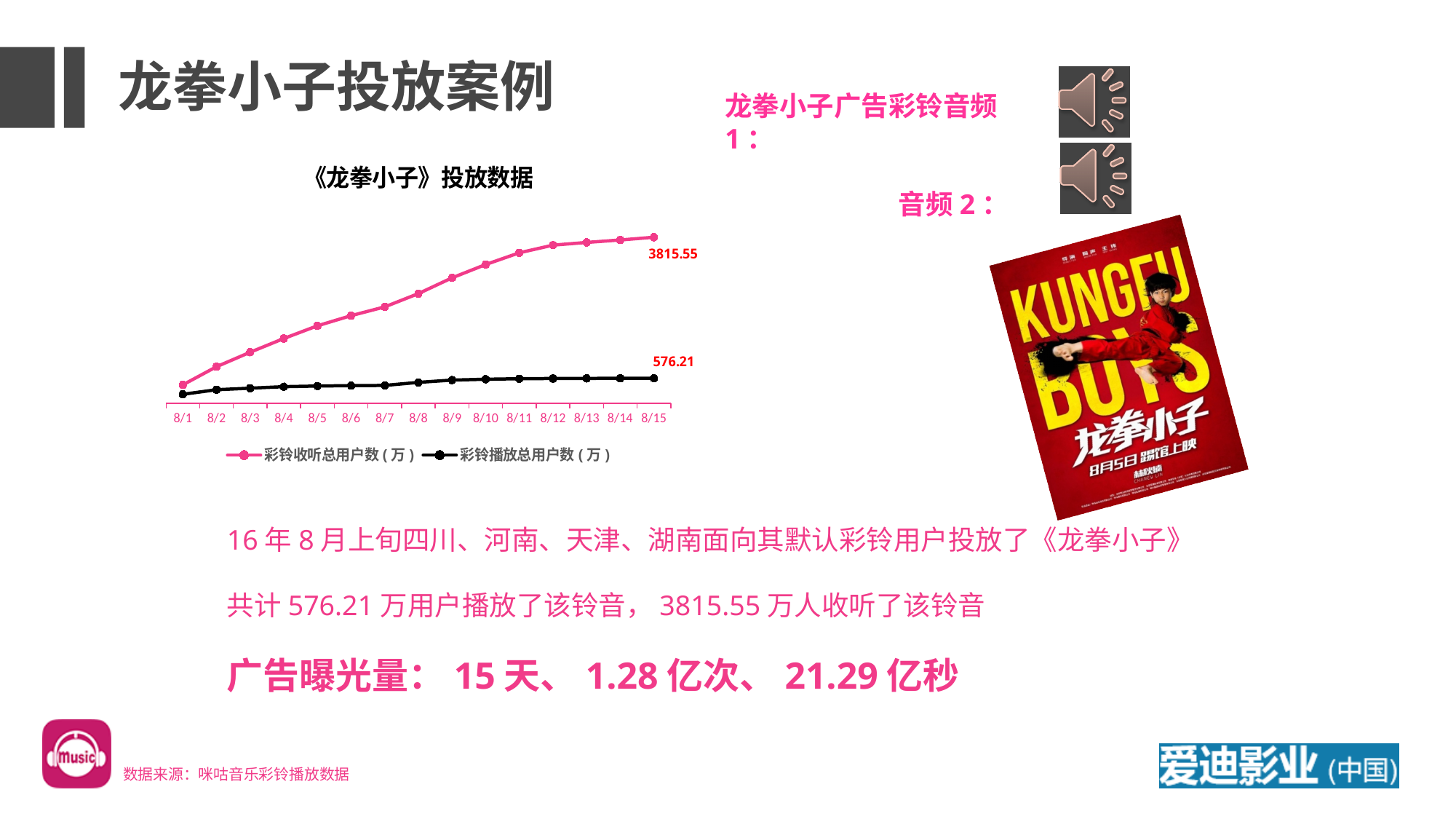
Does the 彩铃收听总用户数（万） series rise or fall from 8/1 to 8/15? Rise On which date is 彩铃播放总用户数（万） at its lowest value? 8/1 How many dates are shown on the x axis of the chart? 15 What is the title of the chart? 《龙拳小子》投放数据 How many series does the chart's legend list? 2 What is the difference between the 8/15 values of 彩铃收听总用户数（万） and 彩铃播放总用户数（万）? 3239.34 What is the value of 彩铃收听总用户数（万） on 8/15? 3815.55 What is the value of 彩铃播放总用户数（万） on 8/15? 576.21 On which date does 彩铃收听总用户数（万） reach its highest value? 8/15 Which series is drawn in pink in the chart? 彩铃收听总用户数（万） On 8/15, which series has the larger value, 彩铃收听总用户数（万） or 彩铃播放总用户数（万）? 彩铃收听总用户数（万） What kind of chart is shown on the slide? Line chart